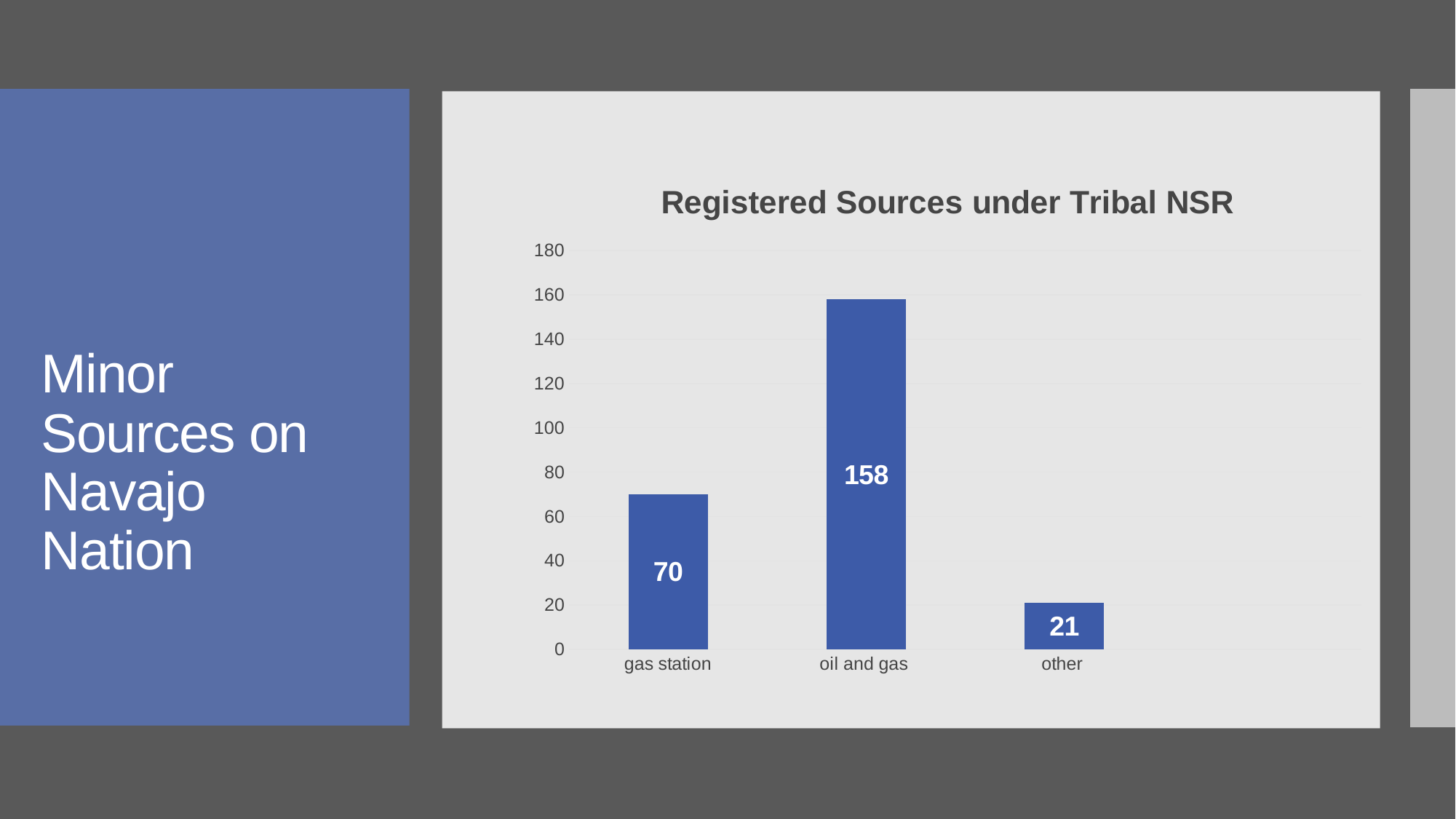
Which category has the highest value? oil and gas What is the value for oil and gas? 158 What is the title of the chart? Registered Sources under Tribal NSR What kind of chart is shown on the slide? bar chart Which is larger, the value for gas station or the value for other? gas station Is the value for oil and gas greater or less than 140? greater Which category has the lowest value? other What is the difference between the values for gas station and other? 49 What is the value for other? 21 What is the difference between the values for oil and gas and gas station? 88 How many categories are shown on the x axis? 3 What is the value for gas station? 70